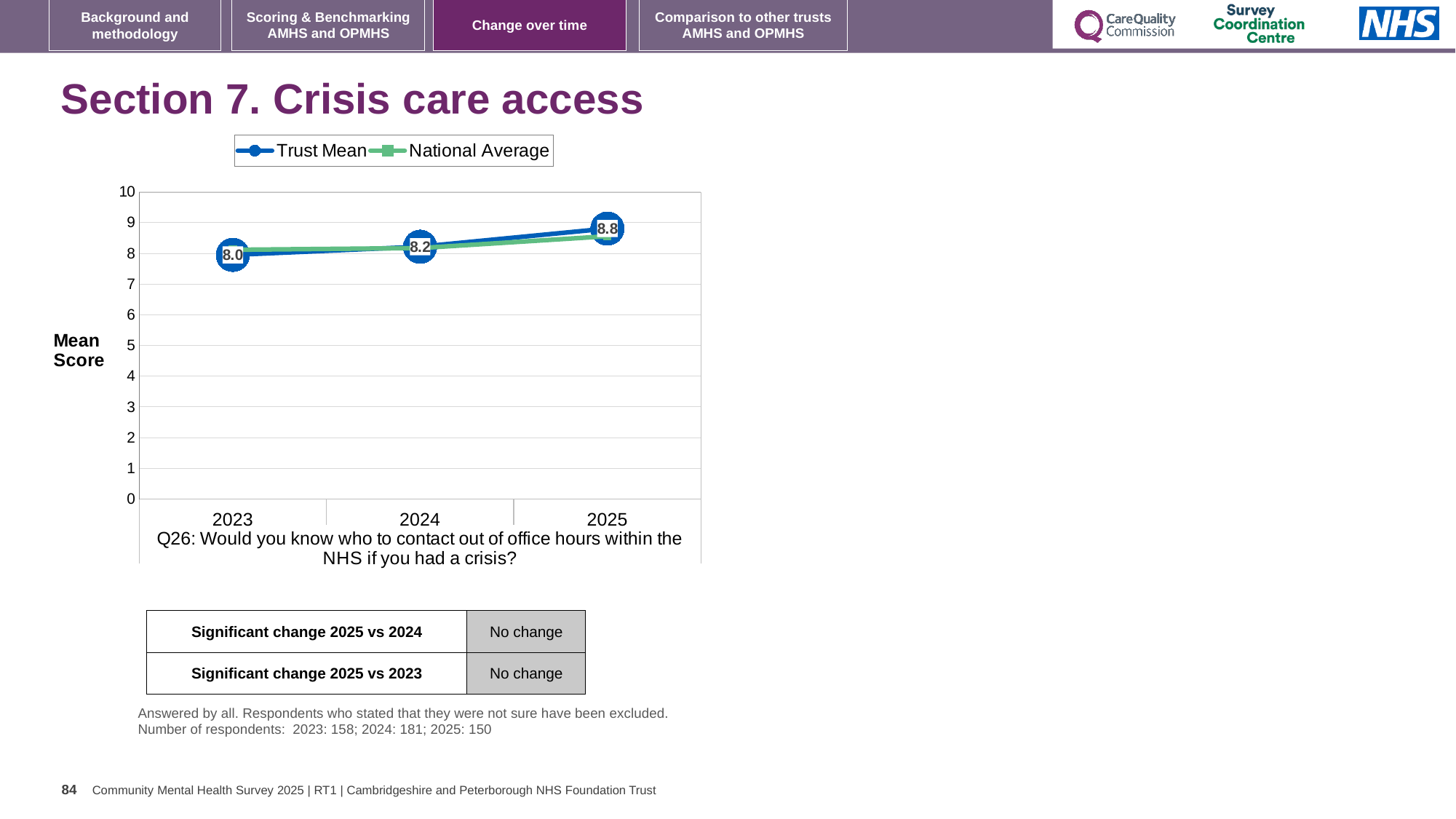
How many years are shown on the x axis of the chart? 3 In which year is the Trust Mean score highest? 2025 What is the Trust Mean score for 2023? 8.0 What is the difference between the Trust Mean score in 2025 and in 2023? 0.8 Is the National Average value for 2025 greater or less than 8? greater How many series does the chart legend list? 2 What kind of chart is shown on the slide? Line chart What is the Trust Mean score for 2025? 8.8 Which is larger, the Trust Mean score in 2025 or in 2024? 2025 What is the Trust Mean score for 2024? 8.2 In which year is the Trust Mean score lowest? 2023 What is the difference between the Trust Mean score in 2025 and in 2024? 0.6